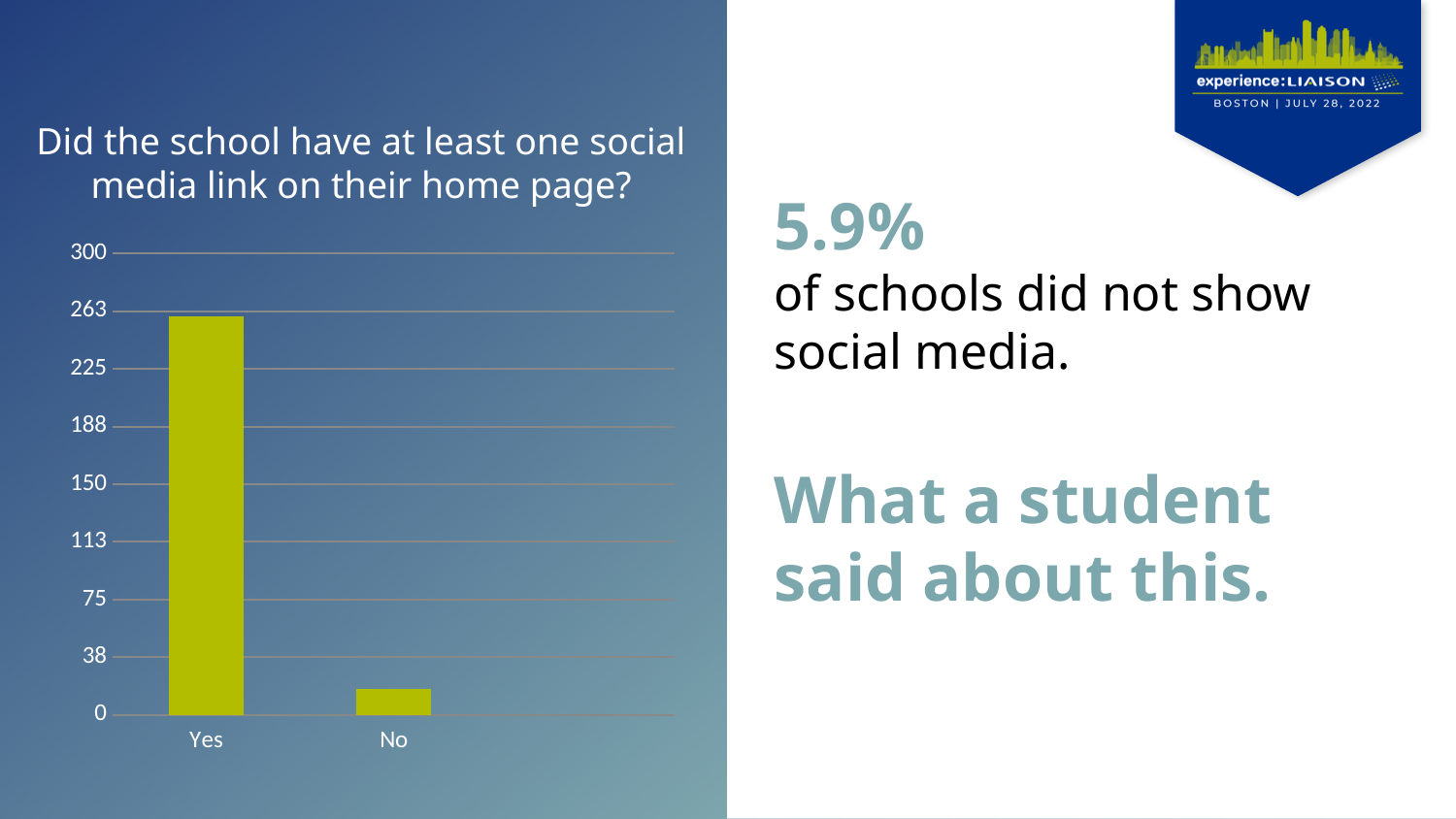
What is the title of the chart? Did the school have at least one social media link on their home page? Do the values rise or fall going from Yes to No along the x axis? fall Which category has the lowest bar in the chart? No Which category has the highest bar in the chart? Yes Is the value for Yes greater or less than 300? less Is the value for Yes greater or less than 225? greater What kind of chart is shown on the slide? bar chart Is the value for No greater or less than 38? less What is the highest value shown on the chart's y axis? 300 Which is larger, the value for Yes or the value for No? Yes How many categories are shown on the x axis of the chart? 2